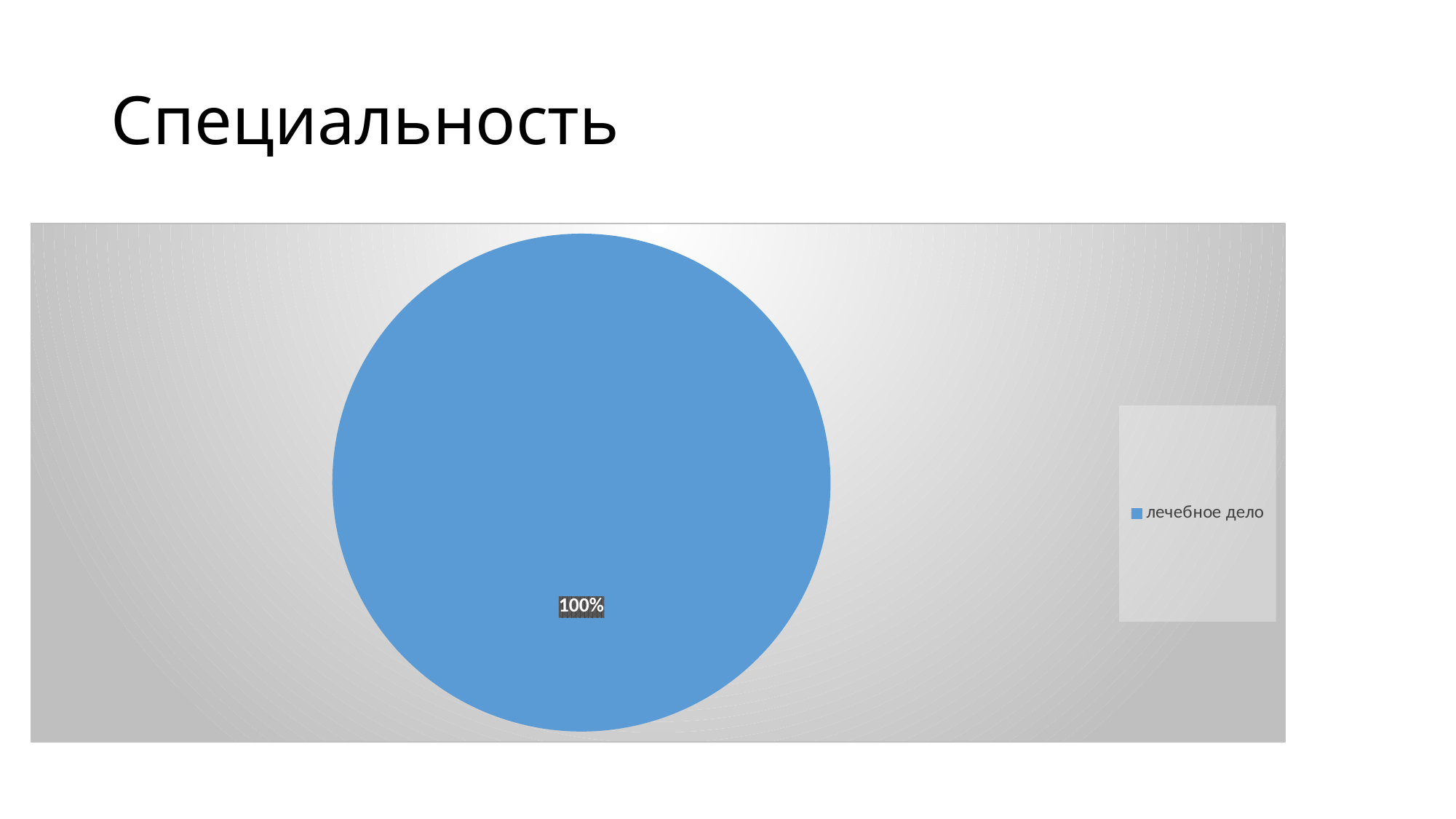
Which category has the largest share of the pie? лечебное дело What category name appears in the legend of the pie chart? лечебное дело How many entries does the legend list? 1 What is the title of the slide containing the pie chart? Специальность How many slices does the pie chart have? 1 What share of the pie does the slice for лечебное дело represent? 100% What kind of chart is shown on the slide? pie chart What is the data label printed on the pie slice? 100%